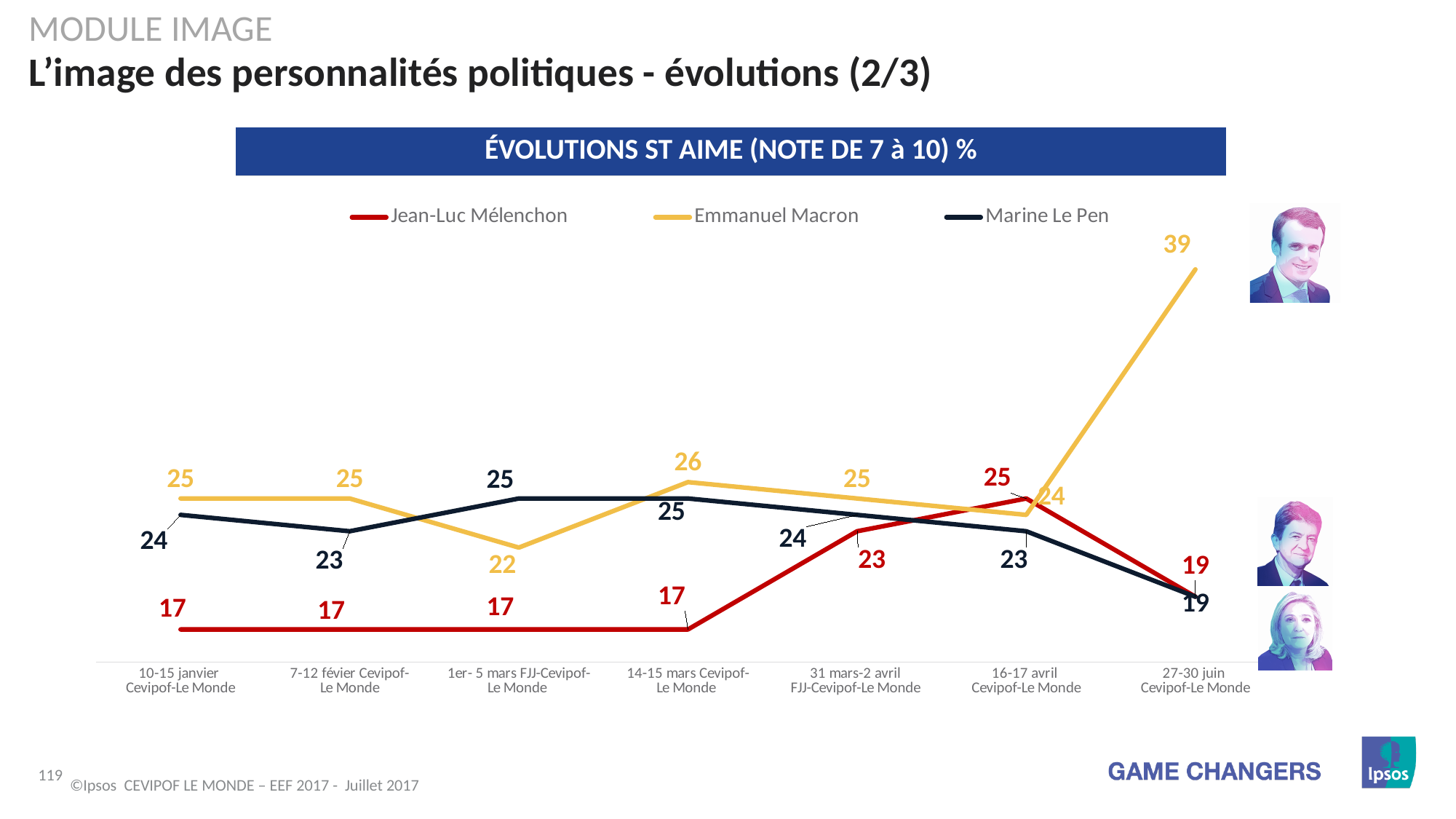
At 1er-5 mars FJJ-Cevipof-Le Monde, which is higher: Marine Le Pen or Emmanuel Macron? Marine Le Pen Does Marine Le Pen's value rise or fall between 16-17 avril and 27-30 juin? fall What is the difference between Emmanuel Macron's value and Marine Le Pen's value at 27-30 juin Cevipof-Le Monde? 20 What is the title of the chart? ÉVOLUTIONS ST AIME (NOTE DE 7 à 10) % What type of chart is shown on the slide? line chart At which survey date does Emmanuel Macron reach his highest value? 27-30 juin Cevipof-Le Monde How many survey dates are plotted along the x axis? 7 What is the value for Emmanuel Macron at 27-30 juin Cevipof-Le Monde? 39 What is the value for Marine Le Pen at 7-12 févier Cevipof-Le Monde? 23 What is the value for Jean-Luc Mélenchon at 16-17 avril Cevipof-Le Monde? 25 What is the lowest value plotted for Emmanuel Macron? 22 How many series does the legend list? 3